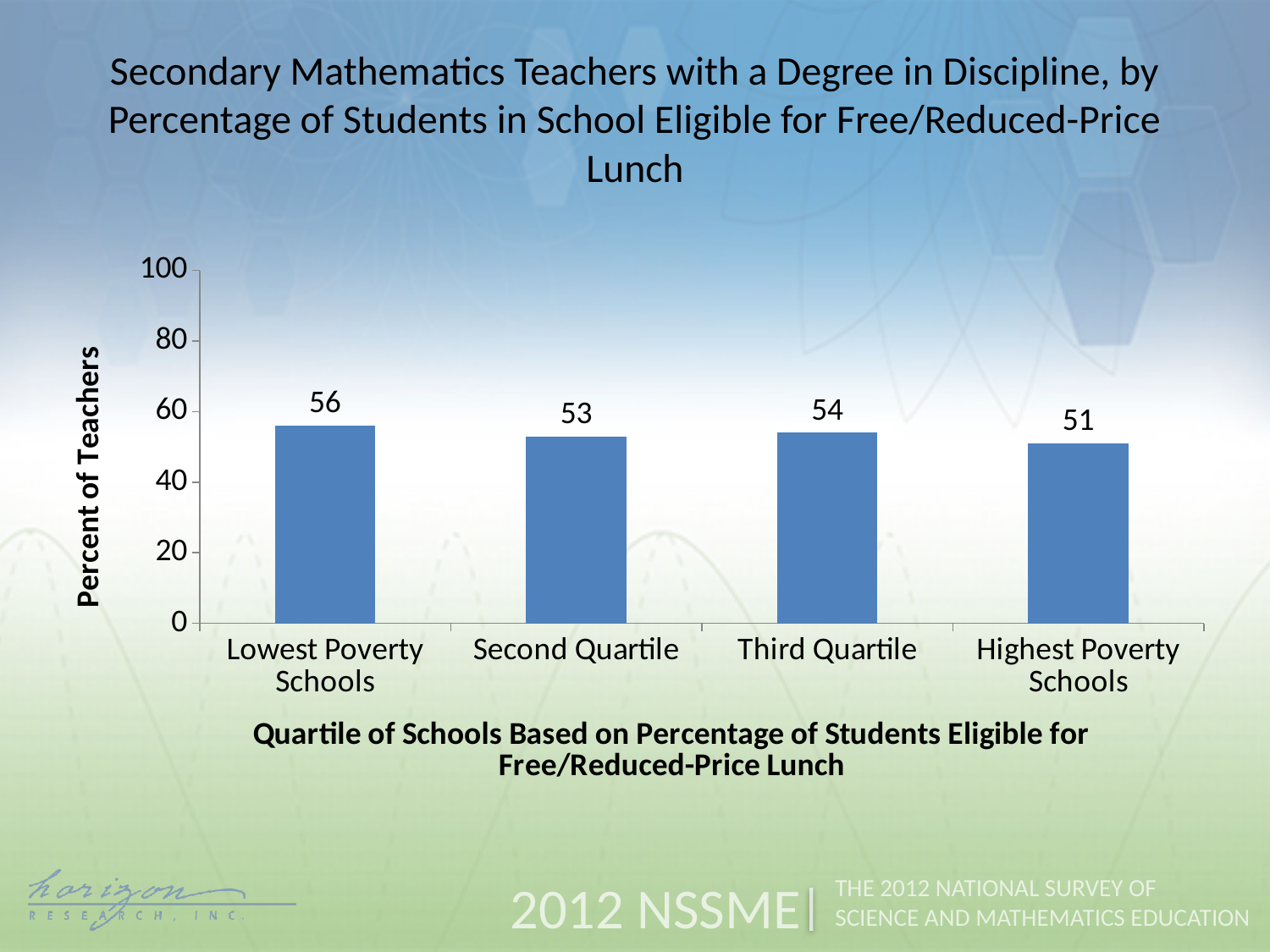
What is the label of the y axis? Percent of Teachers What is the value for Lowest Poverty Schools? 56 What is the value for Highest Poverty Schools? 51 Which category has the lowest value? Highest Poverty Schools What is the value for Third Quartile? 54 How many categories are shown on the x axis? 4 What is the value for Second Quartile? 53 Which is larger, the value for Second Quartile or the value for Third Quartile? Third Quartile What is the difference between the values for Lowest Poverty Schools and Highest Poverty Schools? 5 What kind of chart is shown on the slide? bar chart Which category has the highest value? Lowest Poverty Schools Is the value for Highest Poverty Schools greater or less than 60? less